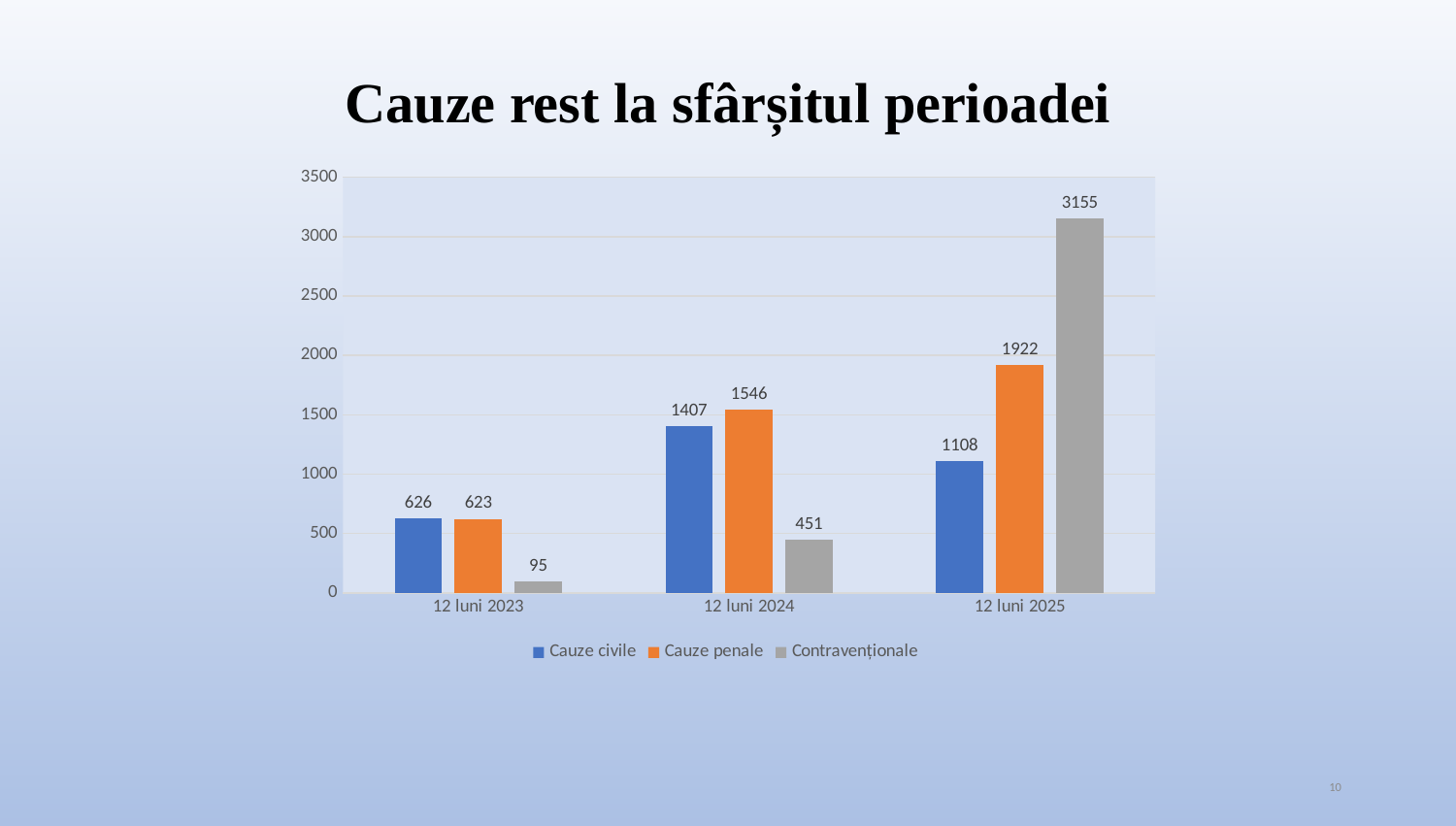
Do the values for Contravenționale rise or fall from 12 luni 2023 to 12 luni 2025? rise How many periods are shown on the x axis? 3 Which is larger in 12 luni 2024: Cauze civile or Cauze penale? Cauze penale What kind of chart is shown on the slide? bar chart What is the value for Contravenționale in 12 luni 2023? 95 What is the value for Cauze civile in 12 luni 2024? 1407 How many series does the legend list? 3 Is the value for Contravenționale in 12 luni 2025 greater or less than 3000? greater Which period has the highest value for Contravenționale? 12 luni 2025 What is the difference between Cauze penale and Cauze civile in 12 luni 2025? 814 Which period has the lowest value for Cauze civile? 12 luni 2023 What is the value for Cauze penale in 12 luni 2025? 1922